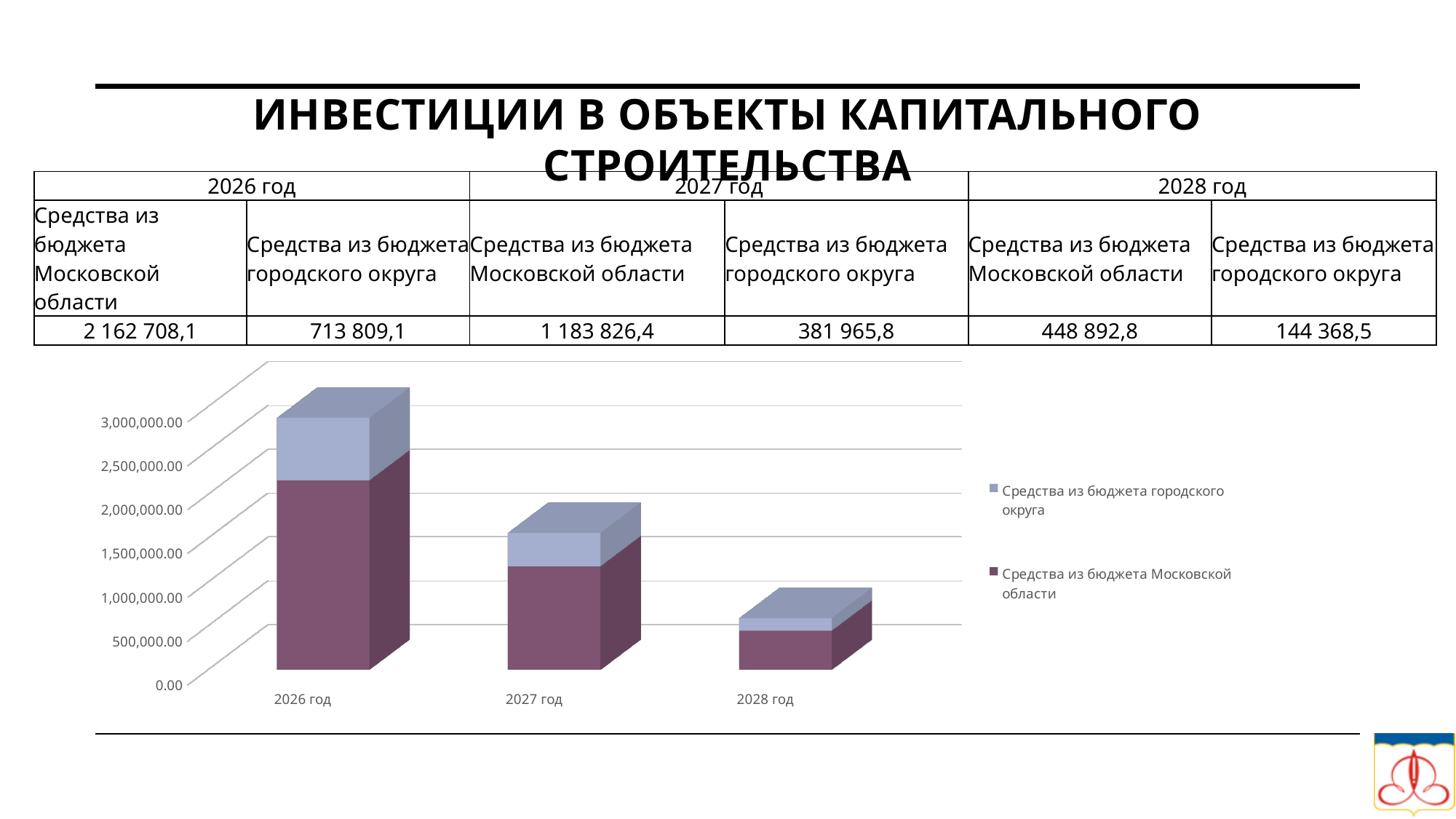
How many series does the chart legend list? 2 According to the slide, what is the value of Средства из бюджета городского округа for 2028 год? 144 368,5 Is the total of the stacked bar for 2028 год greater or less than 1,000,000.00? less Which year has the shortest stacked bar in the chart? 2028 год Which series is shown in the darker purple colour in the chart? Средства из бюджета Московской области Is the total of the stacked bar for 2026 год greater or less than 2,500,000.00? greater How many year categories are plotted on the x axis of the chart? 3 Which year has the tallest stacked bar in the chart? 2026 год According to the slide, what is the value of Средства из бюджета Московской области for 2027 год? 1 183 826,4 Using the values printed on the slide, what is the total of the stacked bar for 2026 год? 2 876 517,2 What kind of chart is shown on the slide? stacked bar chart Do the stacked bar totals rise or fall from 2026 год to 2028 год? fall